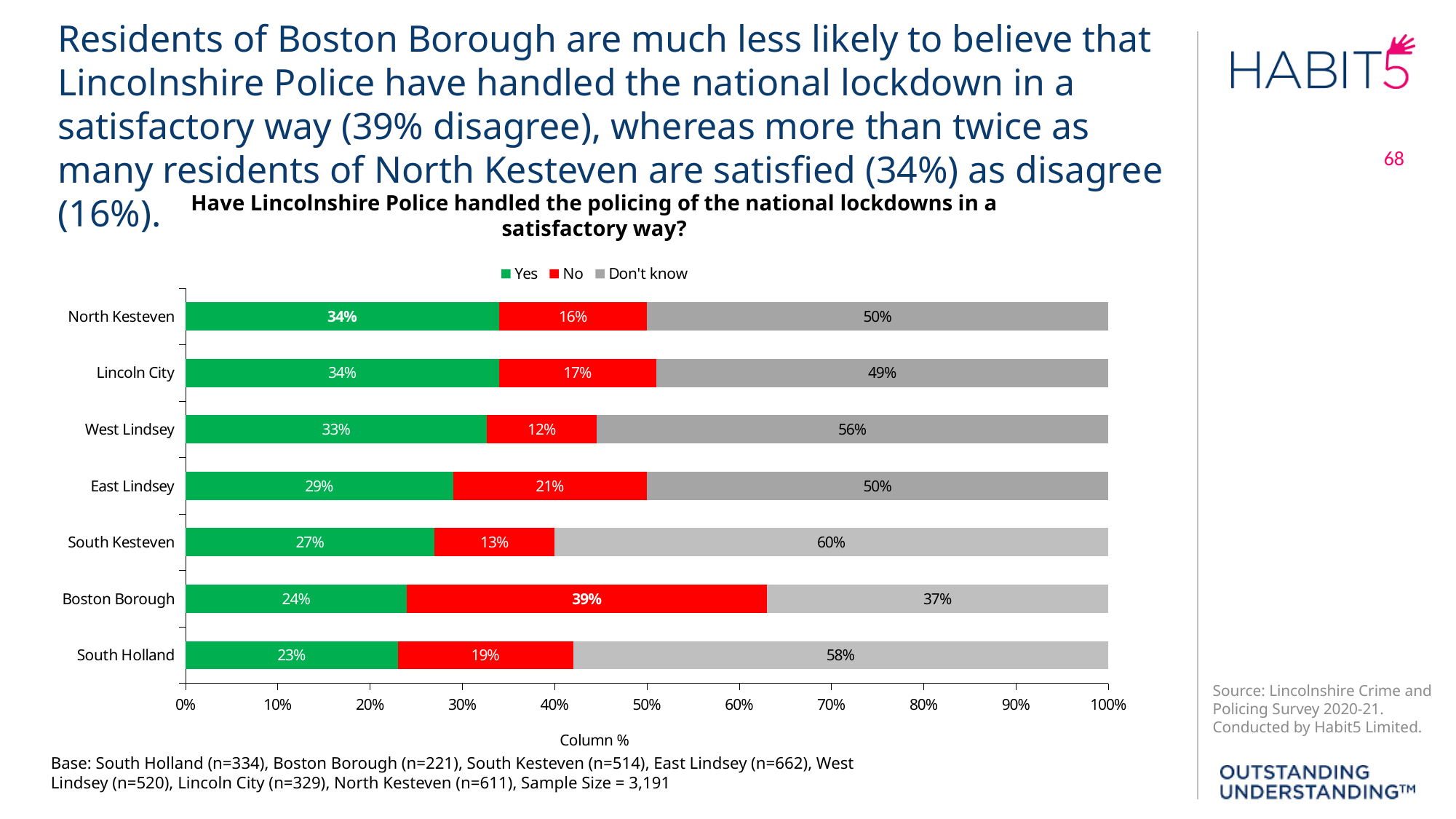
Which area has the lowest 'Yes' percentage? South Holland Which area has the highest 'No' percentage? Boston Borough What is the 'Don't know' value for South Kesteven? 60% How many areas are shown on the chart? 7 What percentage of Boston Borough residents answered 'No'? 39% What type of chart is shown? Stacked bar chart Which is larger: the 'Yes' value for East Lindsey or the 'Yes' value for South Kesteven? East Lindsey Which area has the lowest 'Don't know' percentage? Boston Borough How many series does the legend list? 3 What is the difference between the 'No' percentages for Boston Borough and North Kesteven? 23 percentage points What percentage of North Kesteven residents answered 'Yes'? 34% Which colour represents the 'Don't know' responses? Grey